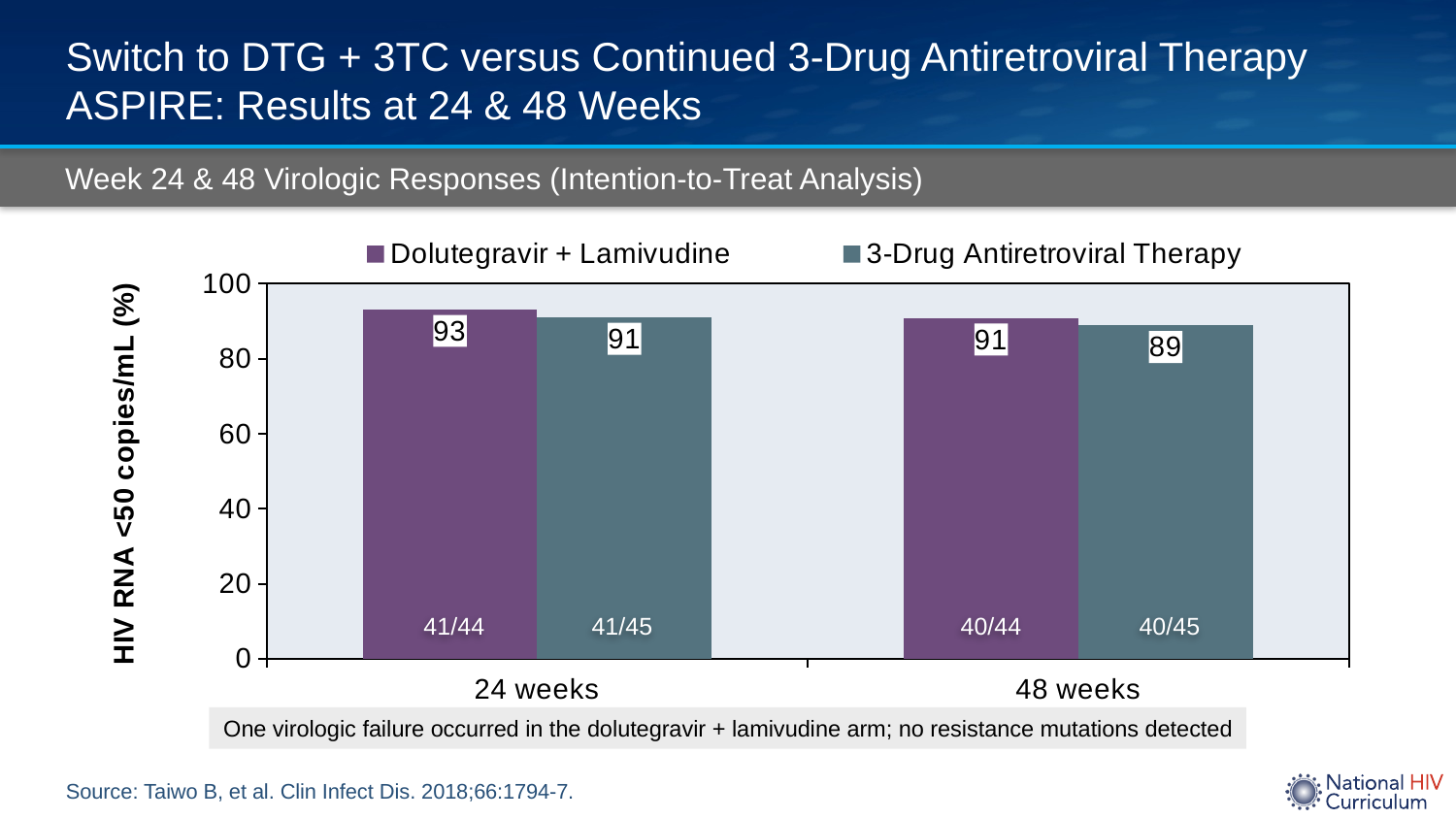
What is the value for 3-Drug Antiretroviral Therapy at 24 weeks? 91 What is the value for Dolutegravir + Lamivudine at 24 weeks? 93 What is the difference between the Dolutegravir + Lamivudine and 3-Drug Antiretroviral Therapy values at 24 weeks? 2 Which bar has the lowest value on the chart? 3-Drug Antiretroviral Therapy at 48 weeks What is the difference between the Dolutegravir + Lamivudine value at 24 weeks and at 48 weeks? 2 What kind of chart is shown on the slide? Bar chart What is the value for 3-Drug Antiretroviral Therapy at 48 weeks? 89 Is the value for 3-Drug Antiretroviral Therapy at 48 weeks greater or less than 80? greater What fraction of patients is shown inside the Dolutegravir + Lamivudine bar at 48 weeks? 40/44 What is the label of the y axis? HIV RNA <50 copies/mL (%) Which is larger: the Dolutegravir + Lamivudine value at 48 weeks or the 3-Drug Antiretroviral Therapy value at 48 weeks? Dolutegravir + Lamivudine How many series does the legend list? 2